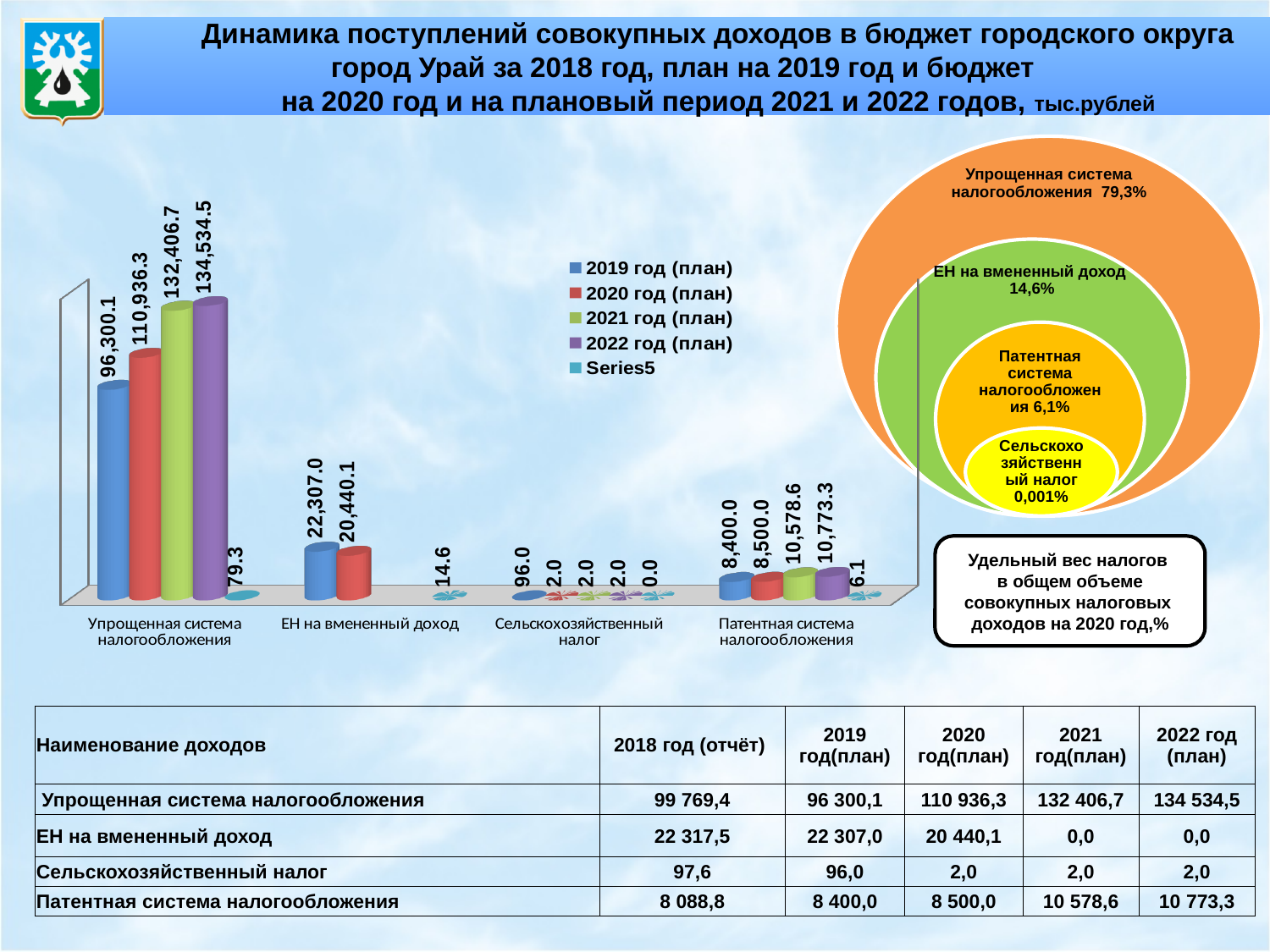
What is the value for Патентная система налогообложения in the 2021 год (план) series? 10,578.6 What is the difference between the 2019 год (план) and 2020 год (план) values for ЕН на вмененный доход? 1,866.9 Which category has the highest value in the 2019 год (план) series? Упрощенная система налогообложения What is the value for Упрощенная система налогообложения in the 2022 год (план) series? 134,534.5 What kind of chart is used to show the income dynamics by category? Bar chart Which category has the lowest value in the 2020 год (план) series? Сельскохозяйственный налог What is the value for ЕН на вмененный доход in the 2020 год (план) series? 20,440.1 Which is larger for Патентная система налогообложения: the 2019 год (план) value or the 2020 год (план) value? 2020 год (план) How many series does the legend of the bar chart list? 5 What is the value for Сельскохозяйственный налог in the 2019 год (план) series? 96.0 What is the difference between the 2022 год (план) and 2021 год (план) values for Упрощенная система налогообложения? 2,127.8 How many categories are shown on the x axis of the bar chart? 4